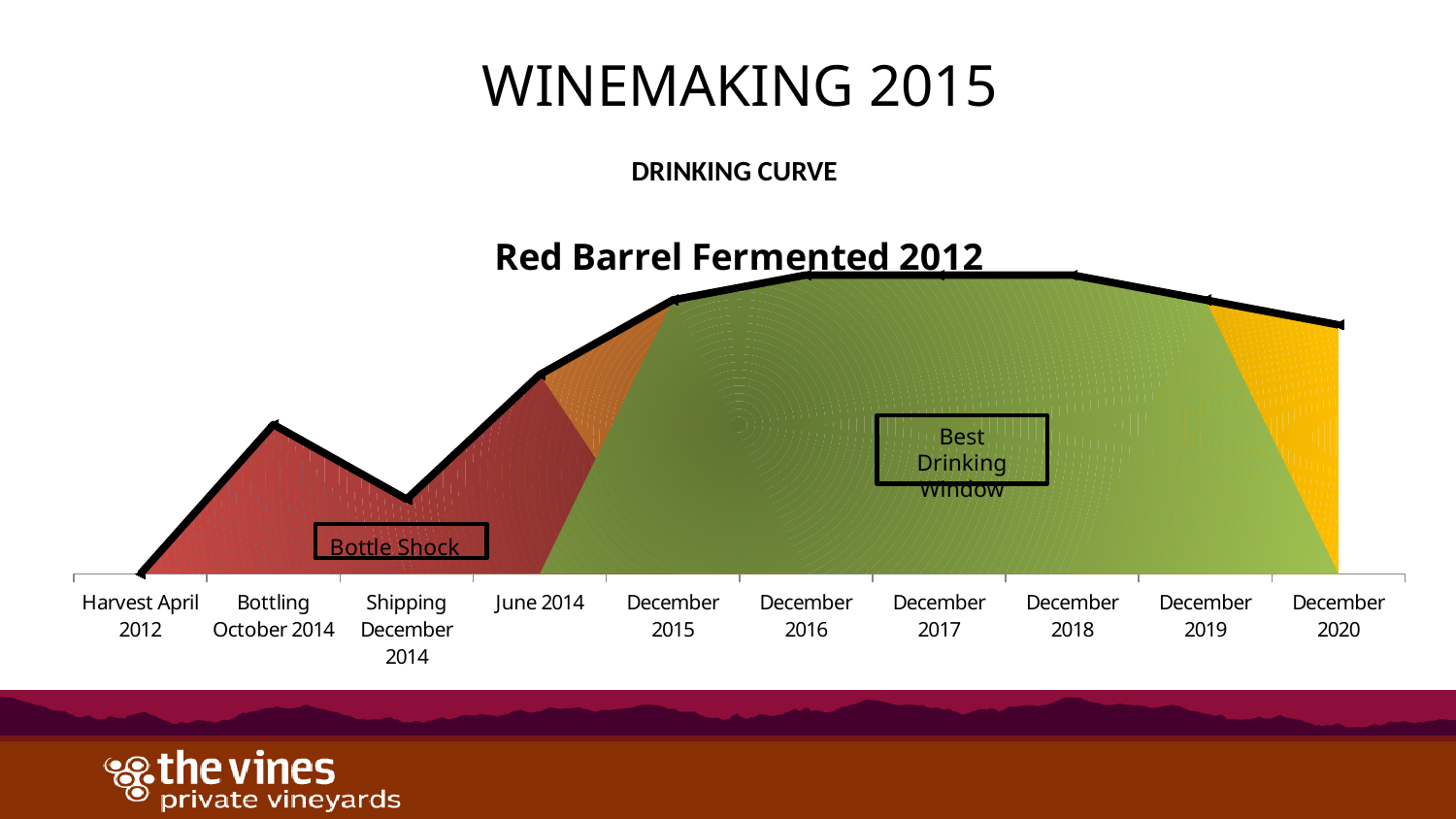
Does the drinking curve rise or fall from Shipping December 2014 to December 2016? rise What kind of chart is shown on the slide? combination area and line chart What label is shown in the box over the dip in the curve near Shipping December 2014? Bottle Shock Does the drinking curve rise or fall from Bottling October 2014 to Shipping December 2014? fall Which is higher on the drinking curve, December 2019 or December 2020? December 2019 Which is higher on the drinking curve, Shipping December 2014 or June 2014? June 2014 Which is higher on the drinking curve, Harvest April 2012 or December 2016? December 2016 Which category has the lowest value on the drinking curve? Harvest April 2012 How many categories are shown along the x axis of the chart? 10 What is the title of the chart? Red Barrel Fermented 2012 Does the drinking curve rise or fall from December 2018 to December 2020? fall